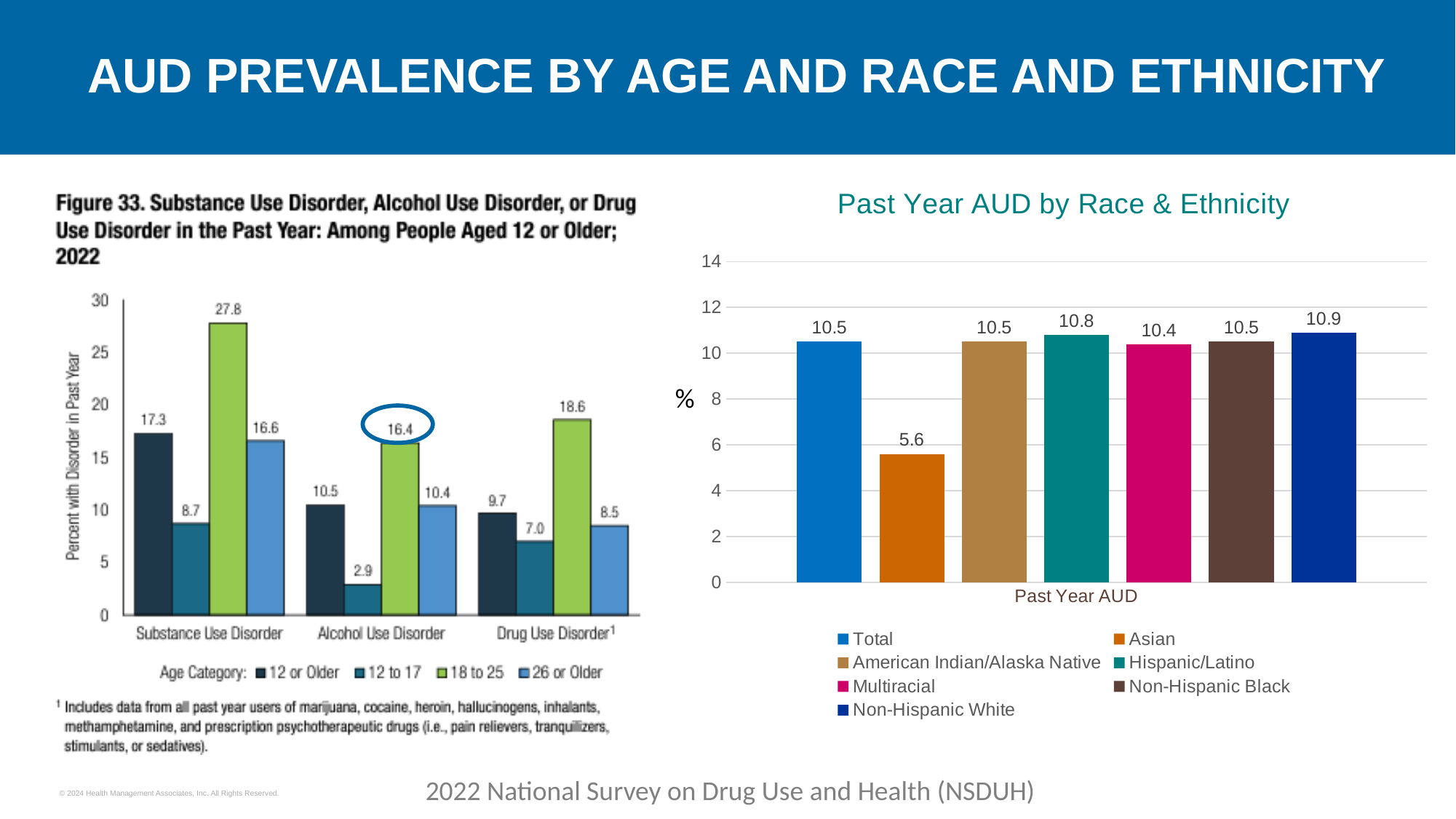
In Figure 33 on the left, what is the difference between the 18 to 25 and 26 or Older values for Drug Use Disorder? 10.1 In Figure 33 on the left, what is the value for the 12 to 17 age group for Alcohol Use Disorder? 2.9 In the 'Past Year AUD by Race & Ethnicity' chart, which group has the highest value? Non-Hispanic White In Figure 33 on the left, which is larger for Substance Use Disorder: the 12 or Older value or the 26 or Older value? 12 or Older In Figure 33 on the left, which age group has the highest value for Substance Use Disorder? 18 to 25 In the 'Past Year AUD by Race & Ethnicity' chart, what is the value for Asian? 5.6 In the 'Past Year AUD by Race & Ethnicity' chart, how many series does the legend list? 7 In the 'Past Year AUD by Race & Ethnicity' chart, what is the value for Non-Hispanic White? 10.9 In Figure 33 on the left, what is the value for the 18 to 25 age group for Alcohol Use Disorder? 16.4 In the 'Past Year AUD by Race & Ethnicity' chart, what is the difference between the Non-Hispanic White value and the Asian value? 5.3 In the 'Past Year AUD by Race & Ethnicity' chart, which group has the lowest value? Asian What kind of chart is the 'Past Year AUD by Race & Ethnicity' chart? Bar chart